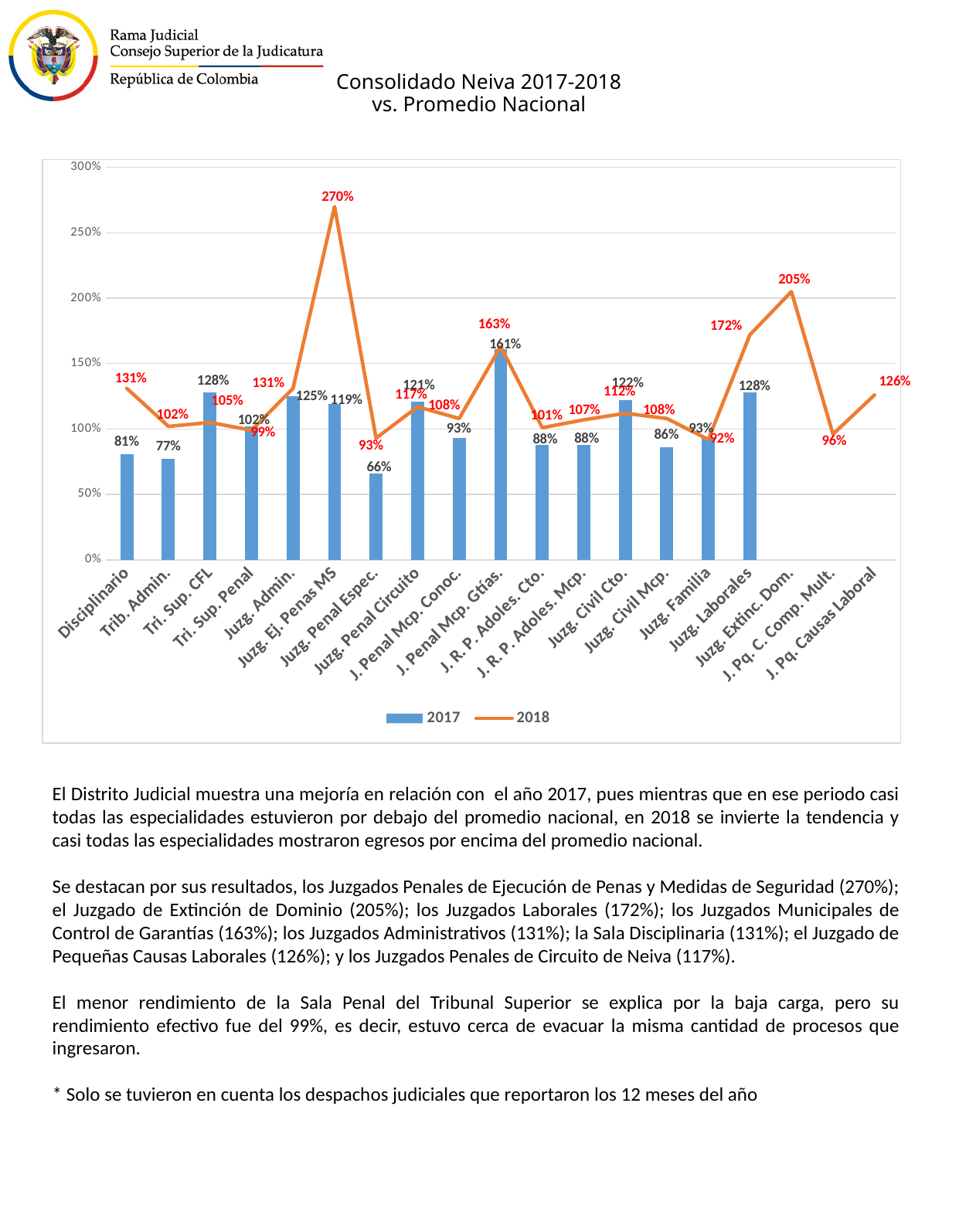
Which category has the lowest 2017 value? Juzg. Penal Espec. How many series does the legend list? 2 What is the 2017 value for Tri. Sup. Penal? 102% Which category has the highest 2017 value? J. Penal Mcp. Gtías. What is the difference between the 2018 and 2017 values for Juzg. Laborales? 44 percentage points For Disciplinario, which is larger: the 2017 value or the 2018 value? 2018 Which category has the highest 2018 value? Juzg. Ej. Penas MS What is the 2018 value for Juzg. Extinc. Dom.? 205% What is the 2017 value for Juzg. Penal Espec.? 66% What is the 2018 value for Juzg. Ej. Penas MS? 270% How many categories are shown on the x axis? 19 What kind of chart is shown on the slide? A bar chart combined with a line